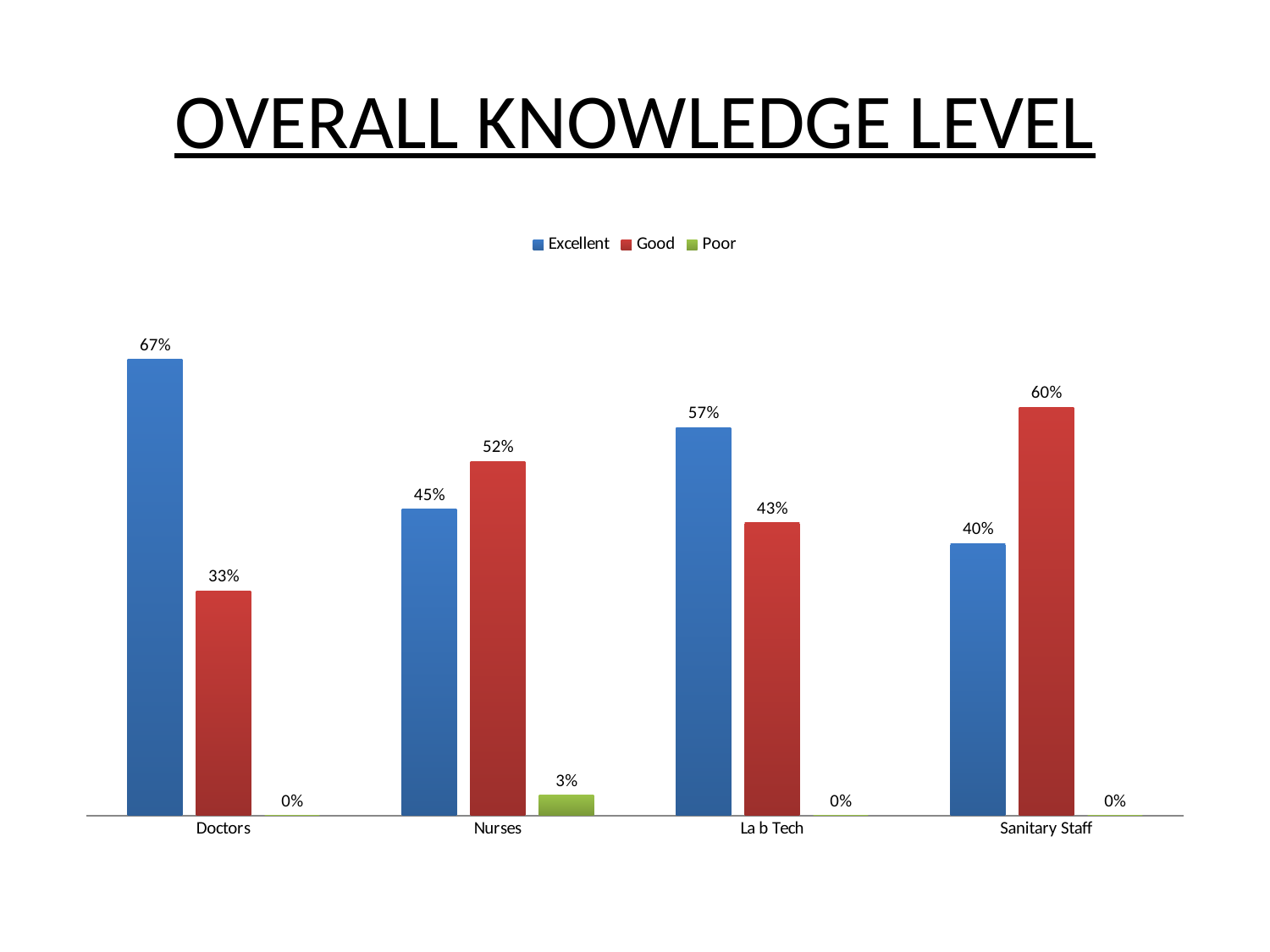
What is the Poor value for Nurses? 3% Which category has the lowest Good value? Doctors What is the Excellent value for Doctors? 67% Which is larger for Nurses, the Excellent value or the Good value? Good How many categories are shown on the x axis? 4 What is the title of the slide? OVERALL KNOWLEDGE LEVEL How many series does the legend list? 3 Which category has the highest Excellent value? Doctors What is the Good value for Sanitary Staff? 60% What is the difference between the Excellent and Good values for Lab Tech? 14% What kind of chart is shown on the slide? Bar chart